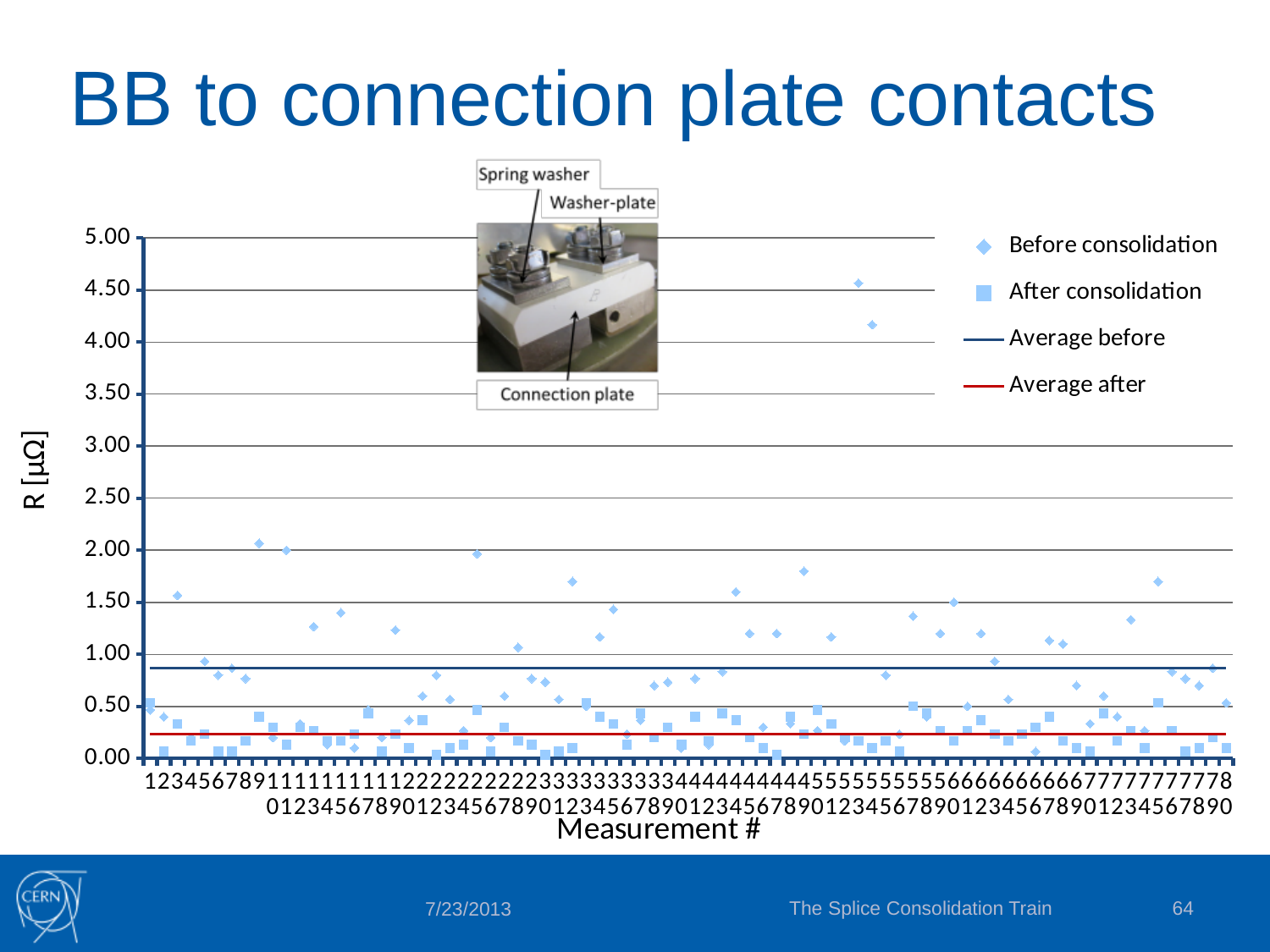
Is the 'Average after' line greater or less than 0.50? less How many measurements are shown along the x axis of the chart? 80 What is the highest value shown on the vertical axis of the chart? 5.00 What kind of chart is shown on the slide? scatter chart How many entries does the chart legend list? 4 What is the title of the slide containing the chart? BB to connection plate contacts Is the highest 'Before consolidation' point greater or less than 4.00? greater What is the label of the vertical axis of the chart? R [μΩ] Which average line is higher on the chart, 'Average before' or 'Average after'? Average before Is the 'Average before' line greater or less than 1.00? less Which series contains the highest plotted point on the chart? Before consolidation